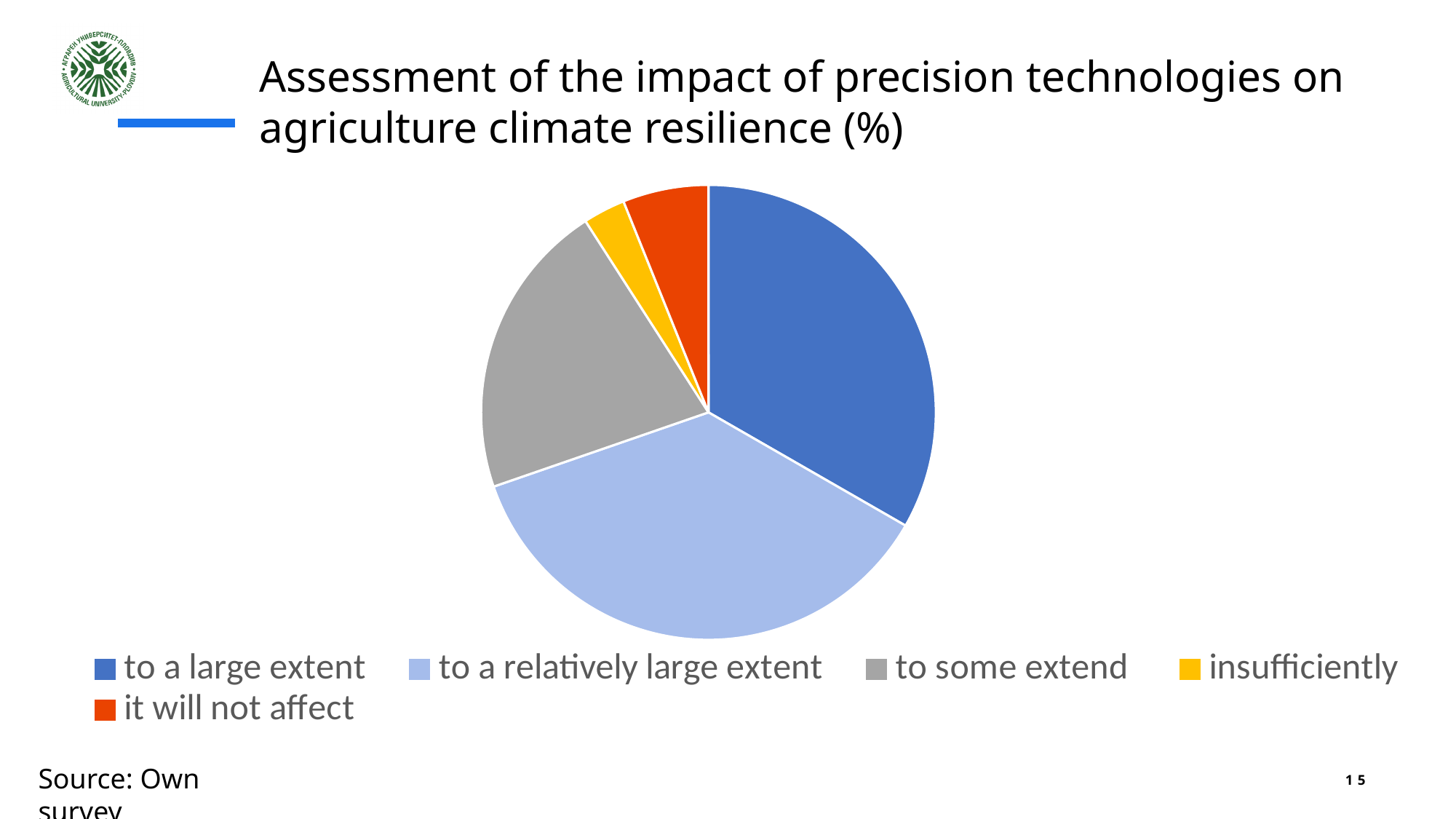
What kind of chart is shown on the slide? pie chart Which category has the largest slice of the pie? to a relatively large extent What colour is the slice for "it will not affect"? red Which slice is larger: "it will not affect" or "insufficiently"? it will not affect Which slice is larger: "to some extend" or "it will not affect"? to some extend Which slice is larger: "to a large extent" or "insufficiently"? to a large extent What is the title of the chart on the slide? Assessment of the impact of precision technologies on agriculture climate resilience (%) How many slices does the pie chart have? 5 Which category has the smallest slice of the pie? insufficiently How many entries does the legend list? 5